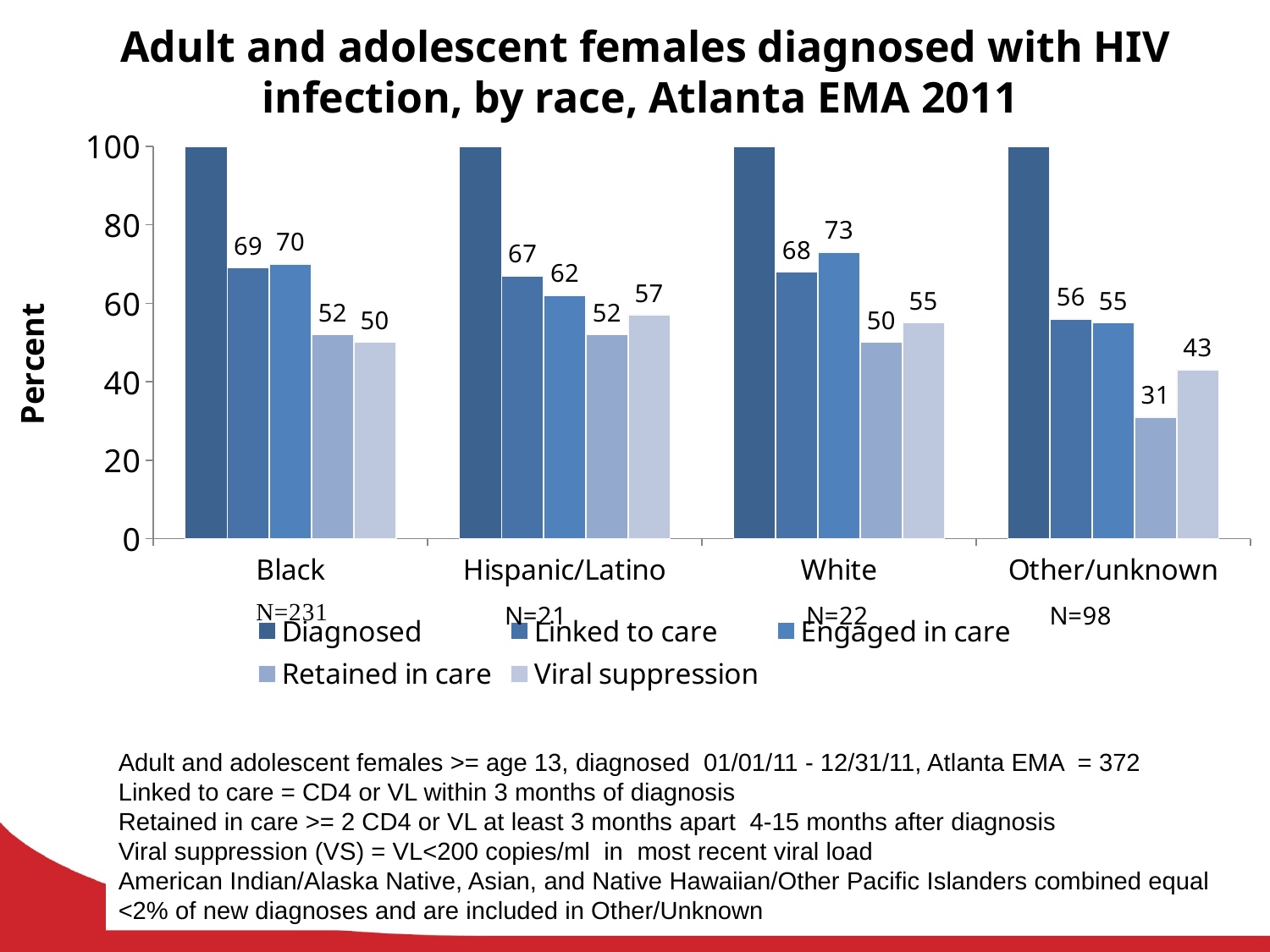
What is the value for Viral suppression in the Hispanic/Latino group? 57 What is the value for Engaged in care in the White group? 73 How many race categories are shown on the x axis? 4 Is the Retained in care value for Other/unknown greater or less than 40? less What is the value for Linked to care in the Black group? 69 Which race group has the highest Engaged in care value? White What is the value for Retained in care in the Other/unknown group? 31 What is the difference between the Linked to care value and the Retained in care value in the Other/unknown group? 25 Which race group has the lowest Viral suppression value? Other/unknown Is the Viral suppression value larger for Black or for White? White How many series does the legend list? 5 What kind of chart is shown on the slide? Bar chart